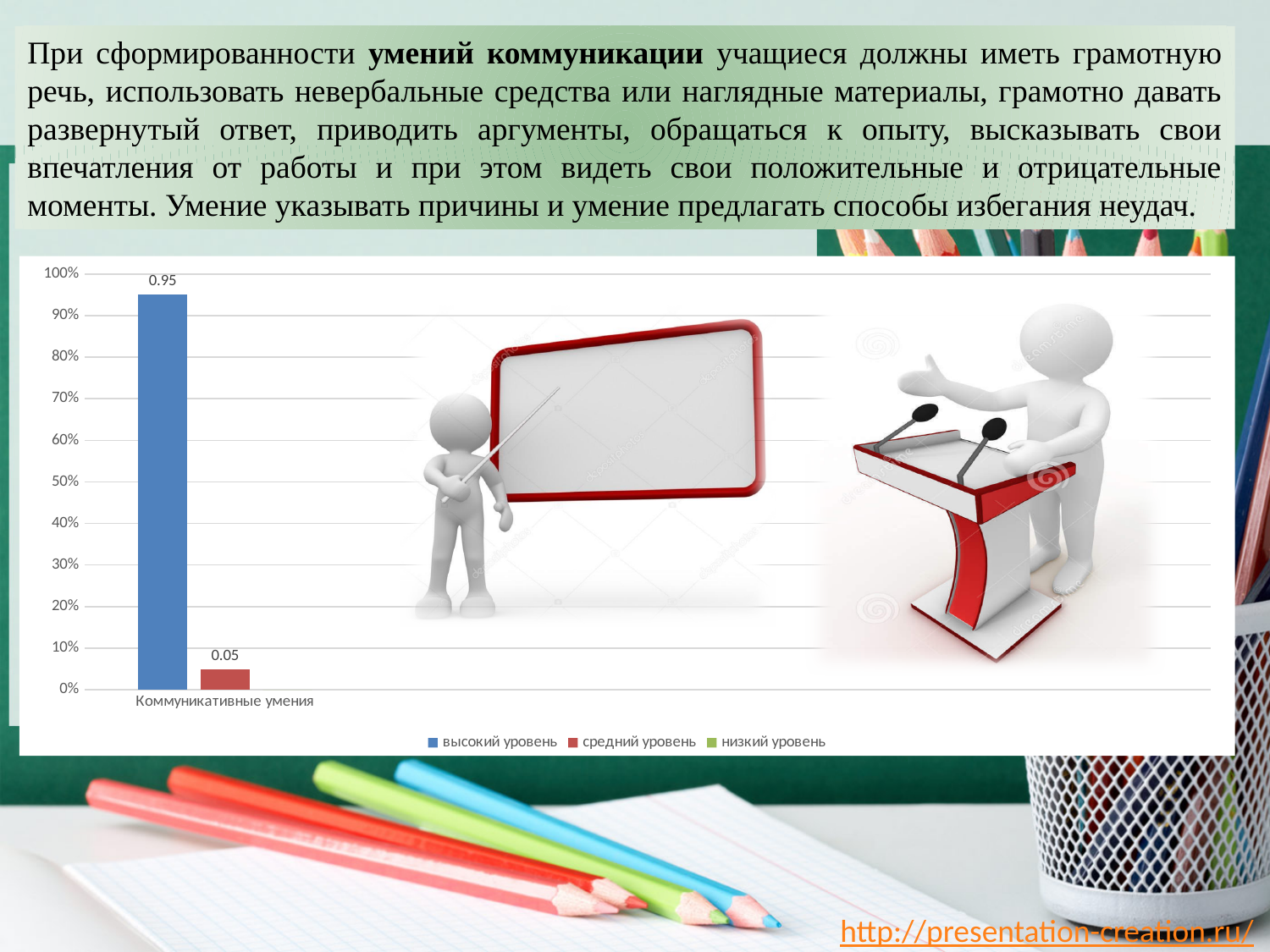
What colour is the 'высокий уровень' series in the chart? blue Which series has the highest value for 'Коммуникативные умения'? высокий уровень What is the difference between the 'высокий уровень' and 'средний уровень' values? 0.9 Is the 'средний уровень' bar greater or less than 10%? less Which is larger for 'Коммуникативные умения': 'высокий уровень' or 'средний уровень'? высокий уровень How many categories are shown on the x axis of the chart? 1 Is the 'высокий уровень' bar greater or less than 90%? greater What kind of chart is shown on the slide? bar chart What is the category label on the x axis of the chart? Коммуникативные умения What is the value of the 'средний уровень' bar for 'Коммуникативные умения'? 0.05 How many series does the chart legend list? 3 What is the value of the 'высокий уровень' bar for 'Коммуникативные умения'? 0.95